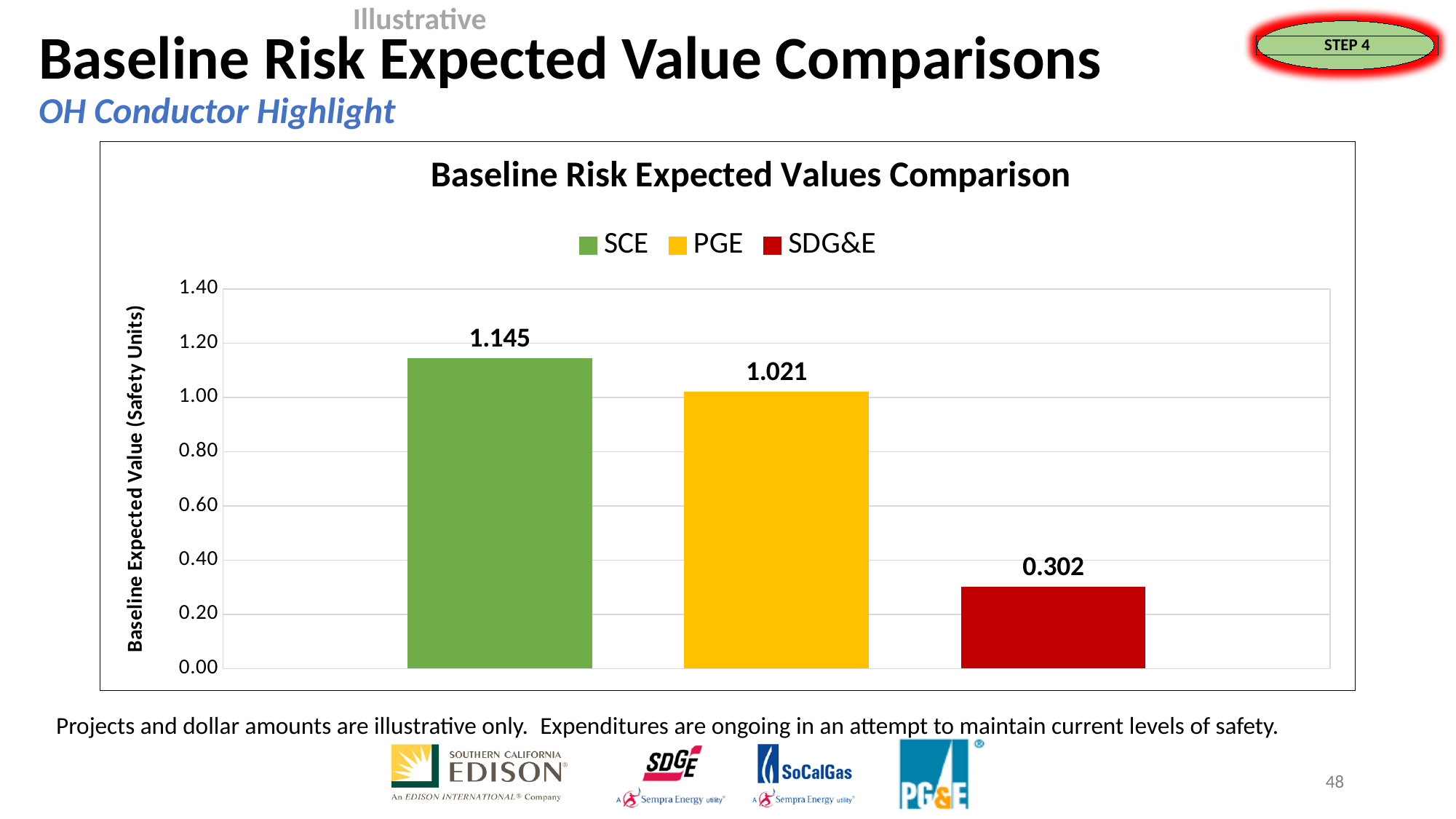
How many series does the legend list? 3 Which utility has the highest baseline expected value? SCE Which utility has the lowest baseline expected value? SDG&E What is the difference between the PGE and SDG&E baseline expected values? 0.719 What is the baseline expected value for SCE? 1.145 What is the baseline expected value for SDG&E? 0.302 What is the baseline expected value for PGE? 1.021 Is the value for SDG&E greater or less than 0.40? less How many bars are shown in the chart? 3 Which is larger, the value for PGE or the value for SDG&E? PGE What is the difference between the SCE and PGE baseline expected values? 0.124 What type of chart is shown on the slide? Bar chart